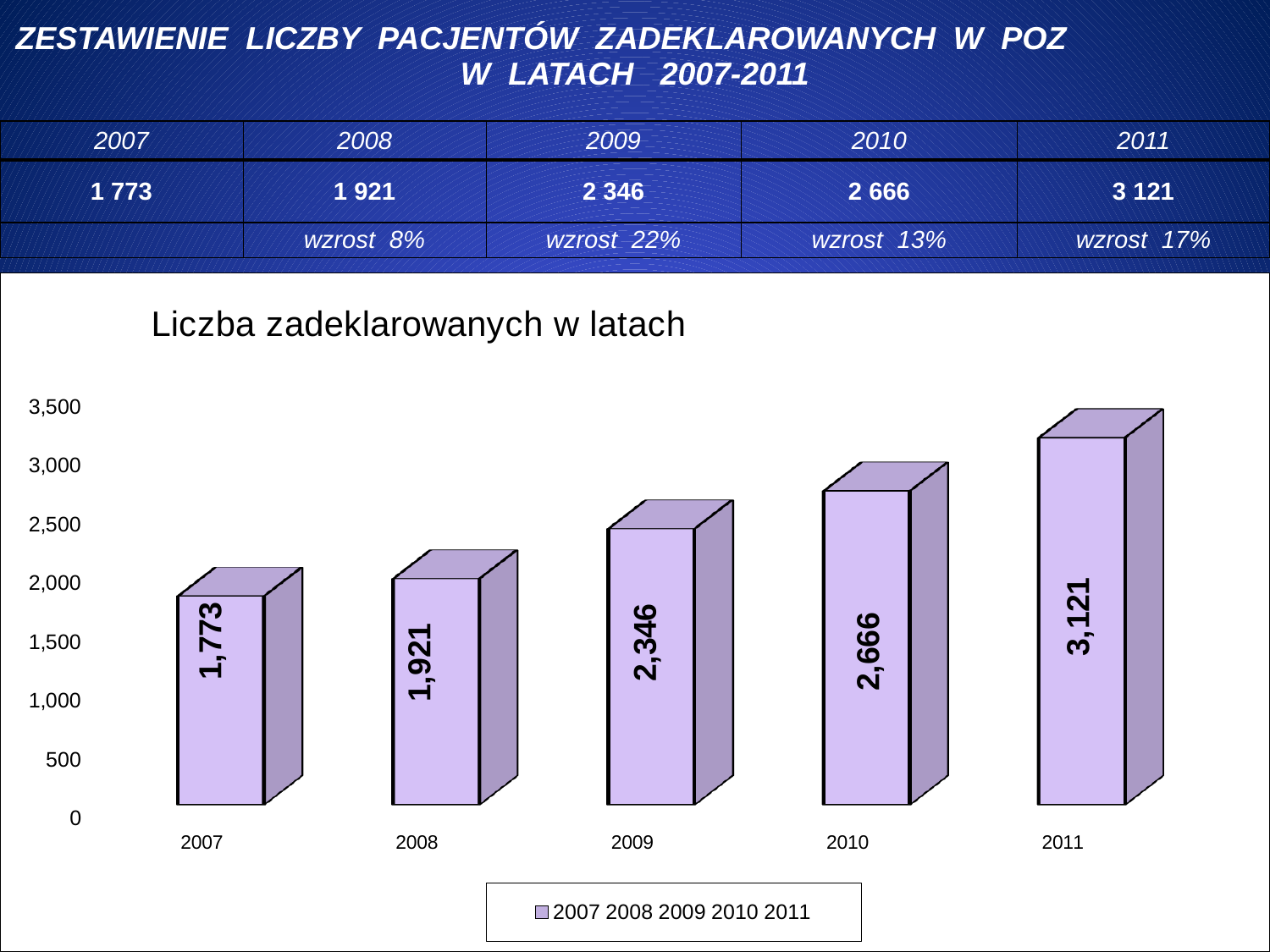
What is the value for 2009 in the chart? 2,346 What is the difference between the values for 2011 and 2010? 455 How many years are shown on the x axis of the chart? 5 Which is larger, the value for 2009 or the value for 2010? 2010 Do the values rise or fall from 2007 to 2011? rise What is the difference between the values for 2008 and 2007? 148 What is the value for 2011 in the chart? 3,121 Which year has the lowest value in the chart? 2007 What is the value for 2007 in the chart? 1,773 What kind of chart is shown on the slide? bar chart Is the value for 2010 greater or less than 2,500? greater Which year has the highest value in the chart? 2011